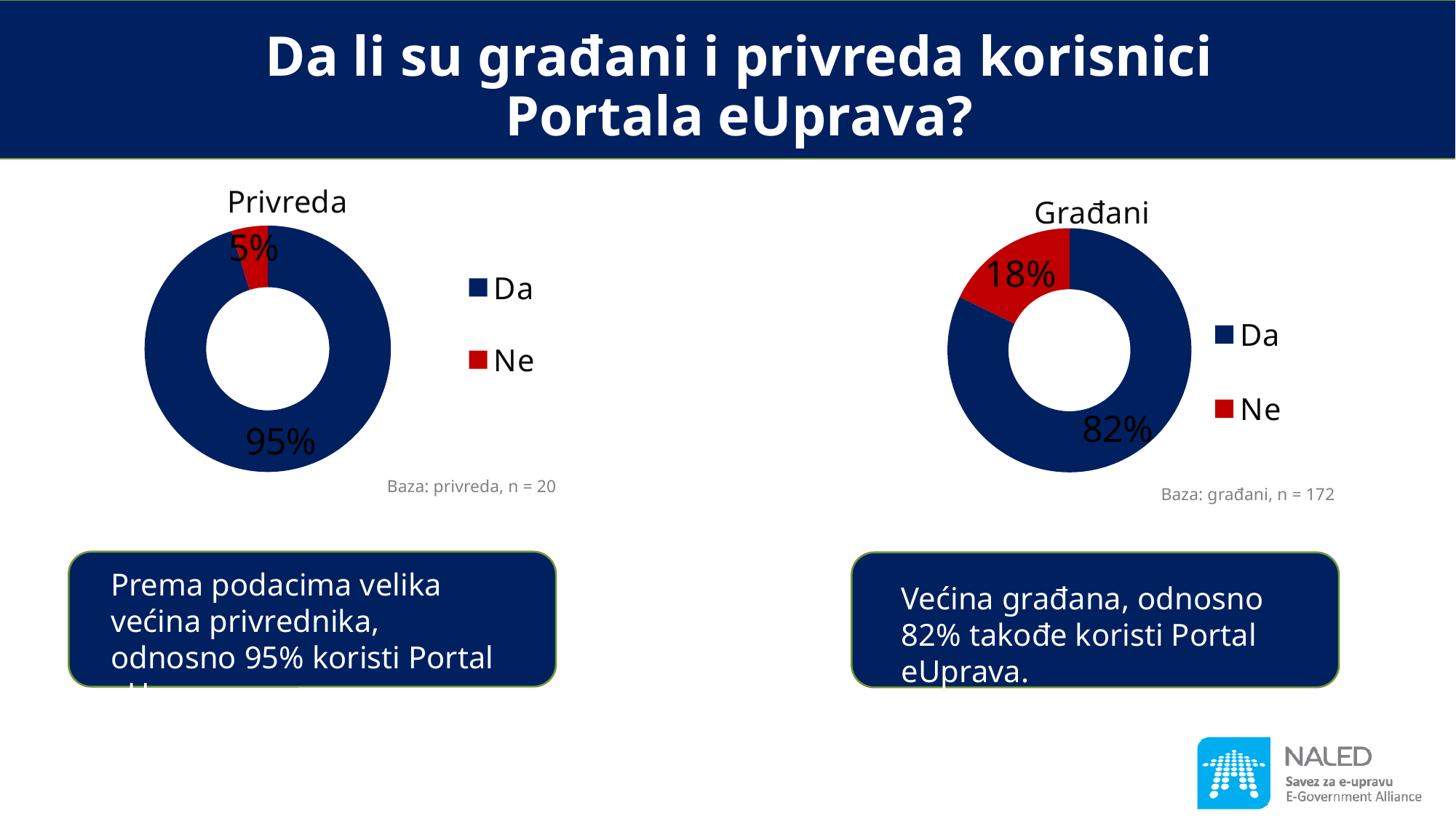
What is the sample size (n) stated below the 'Građani' chart? 172 In the 'Građani' chart, what percentage is shown for 'Ne'? 18% In the 'Privreda' chart, what percentage is shown for 'Ne'? 5% Which is larger: the 'Ne' share in the 'Privreda' chart or the 'Ne' share in the 'Građani' chart? Građani What kind of chart is the 'Privreda' chart? Doughnut chart In the 'Građani' chart, what is the difference between the 'Da' and 'Ne' shares? 64% In the 'Privreda' chart, what colour represents 'Ne'? Red In the 'Građani' chart, what percentage is shown for 'Da'? 82% In the 'Privreda' chart, which category has the largest share? Da In the 'Privreda' chart, what percentage is shown for 'Da'? 95% In the 'Građani' chart, which category has the smallest share? Ne How many categories does the legend of the 'Građani' chart list? 2